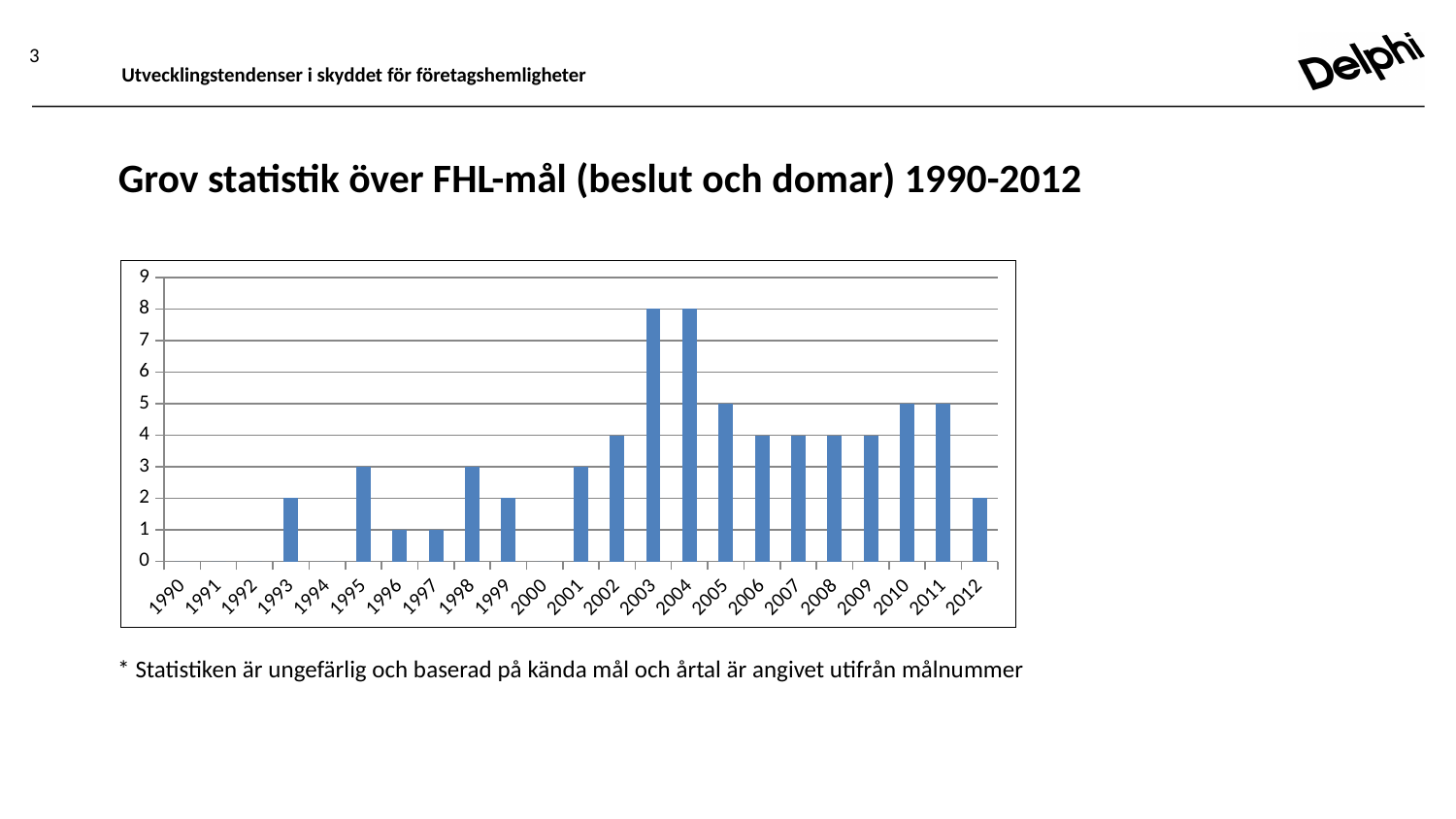
What kind of chart is shown on the slide? Bar chart Which is larger, the value for 2002 or the value for 2010? 2010 What is the difference between the values for 2004 and 2012? 6 What is the value for 1993? 2 What is the highest value shown in the chart? 8 What is the value for 2003? 8 How many years are shown on the x axis? 23 Is the value for 2003 greater or less than 6? greater What is the value for 2005? 5 Do the values rise or fall from 2001 to 2003? Rise What is the value for 1996? 1 What is the title of the slide above the chart? Grov statistik över FHL-mål (beslut och domar) 1990-2012